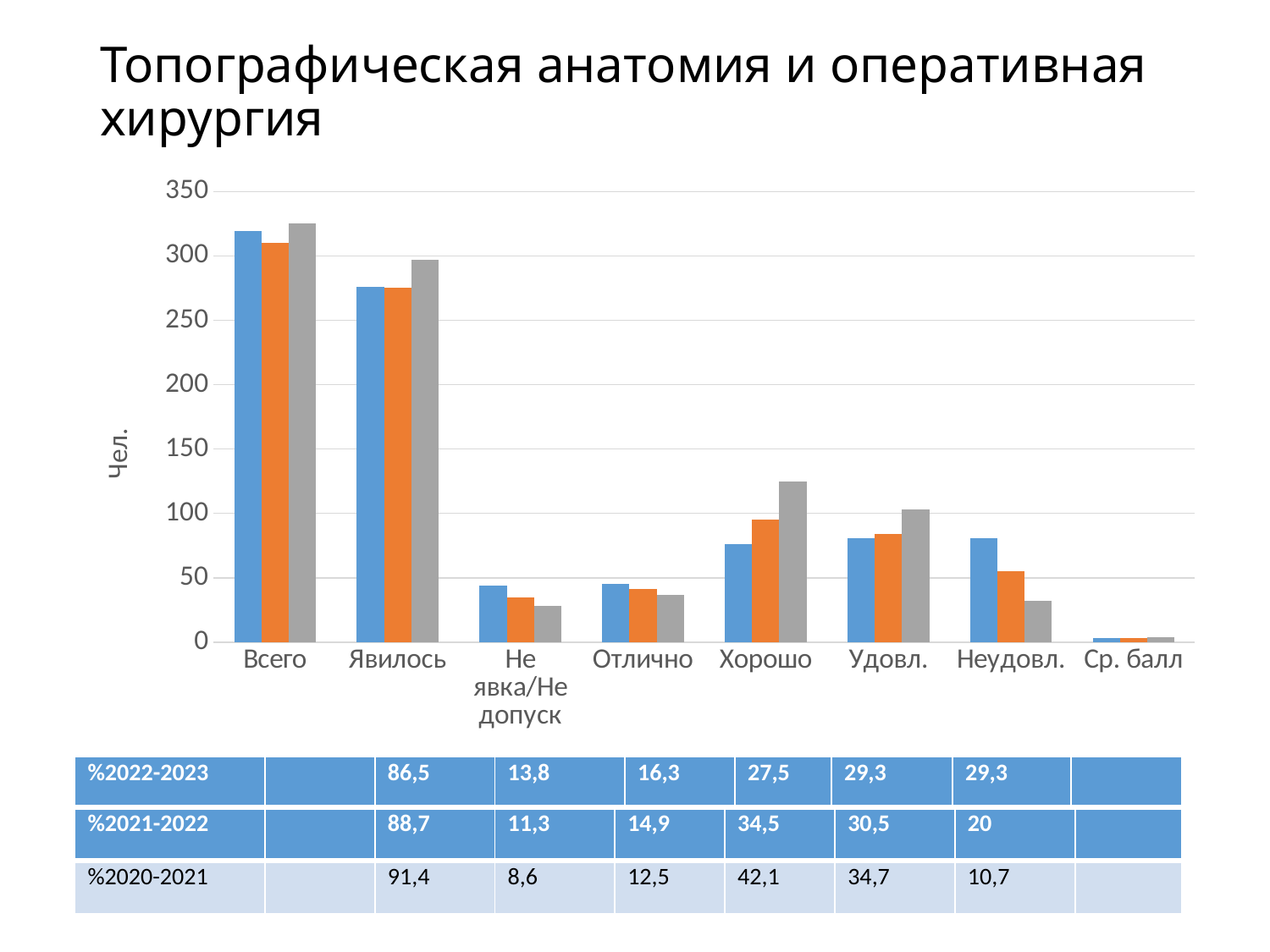
What is the label on the vertical axis of the chart? Чел. What kind of chart is shown on the slide? bar chart How many bars are plotted for each category in the chart? 3 Is the value of the gray bar for Хорошо greater or less than 100? greater Is the value of the blue bar for Не явка/Не допуск greater or less than 50? less How many categories are shown on the x axis of the chart? 8 Is the value of the blue bar for Всего greater or less than 300? greater For the category Хорошо, which bar is larger: the blue bar or the gray bar? gray bar Which category has the lowest bars in the chart? Ср. балл For the category Неудовл., which bar is larger: the blue bar or the orange bar? blue bar Which category has the tallest bars in the chart? Всего